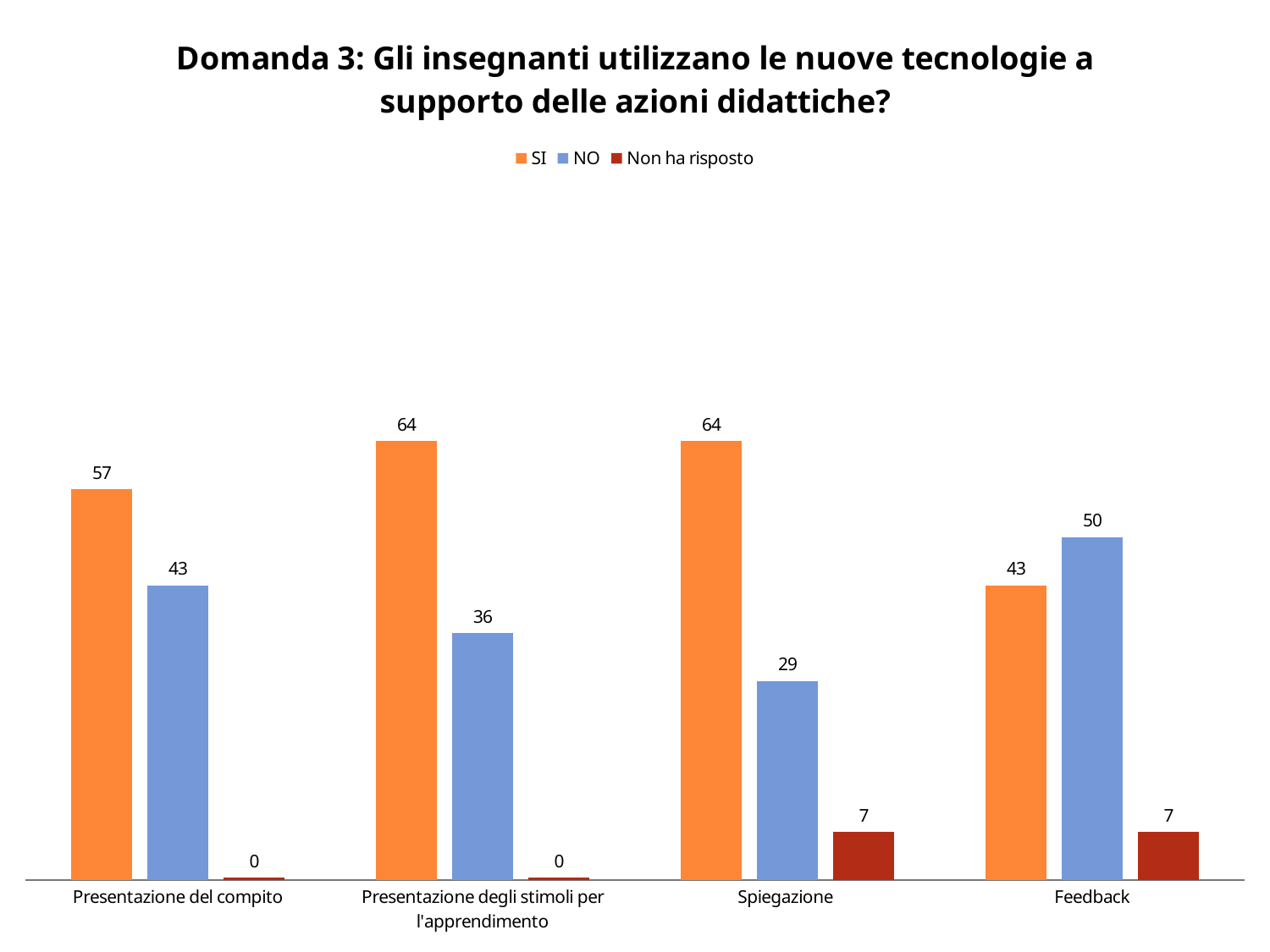
What is the difference between the SI and NO values for Spiegazione? 35 What is the NO value for Feedback? 50 Which category has the highest NO value? Feedback How many categories are shown on the x axis? 4 What kind of chart is shown on the slide? Bar chart What is the NO value for Presentazione degli stimoli per l'apprendimento? 36 Which series is shown in orange? SI How many series does the legend list? 3 For Feedback, which is larger, the SI value or the NO value? NO What is the SI value for Spiegazione? 64 What is the Non ha risposto value for Presentazione del compito? 0 Which category has the lowest SI value? Feedback